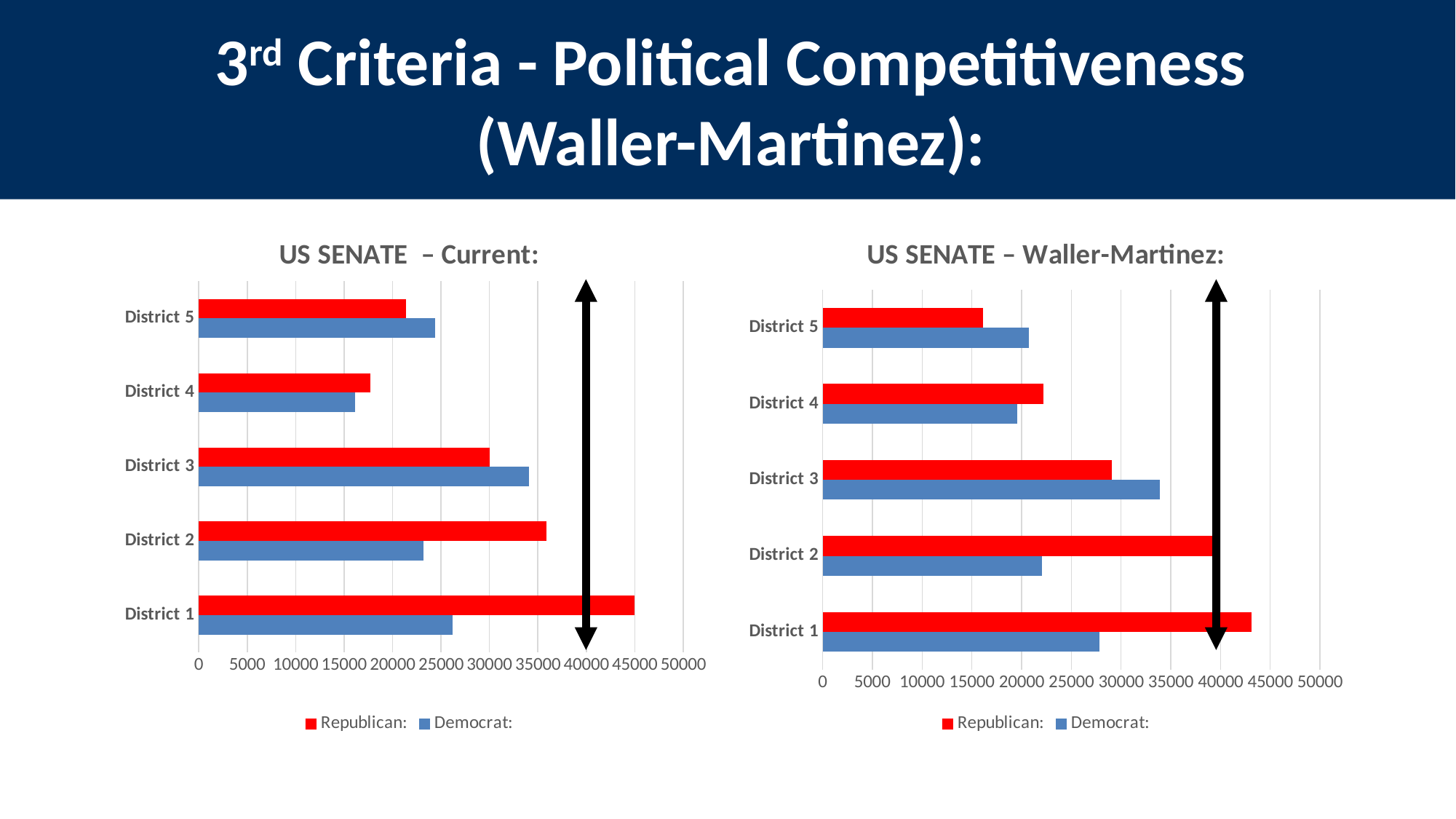
In the "US SENATE – Current:" chart, how many series does the legend list? 2 In the "US SENATE – Waller-Martinez:" chart, which is larger for District 2, the Republican value or the Democrat value? Republican In the "US SENATE – Current:" chart, which is larger for District 3, the Republican value or the Democrat value? Democrat In the "US SENATE – Waller-Martinez:" chart, how many districts are shown? 5 In the "US SENATE – Current:" chart, is the Republican value for District 2 greater or less than 30000? greater In the "US SENATE – Waller-Martinez:" chart, which district has the highest Republican value? District 1 In the "US SENATE – Current:" chart, which district has the highest Republican value? District 1 In the "US SENATE – Current:" chart, which district has the lowest Democrat value? District 4 In the "US SENATE – Current:" chart, what colour represents the Republican series? Red In the "US SENATE – Waller-Martinez:" chart, is the Democrat value for District 1 greater or less than 25000? greater In the "US SENATE – Waller-Martinez:" chart, which district has the lowest Republican value? District 5 What kind of chart is the "US SENATE – Current:" chart on the left? Bar chart